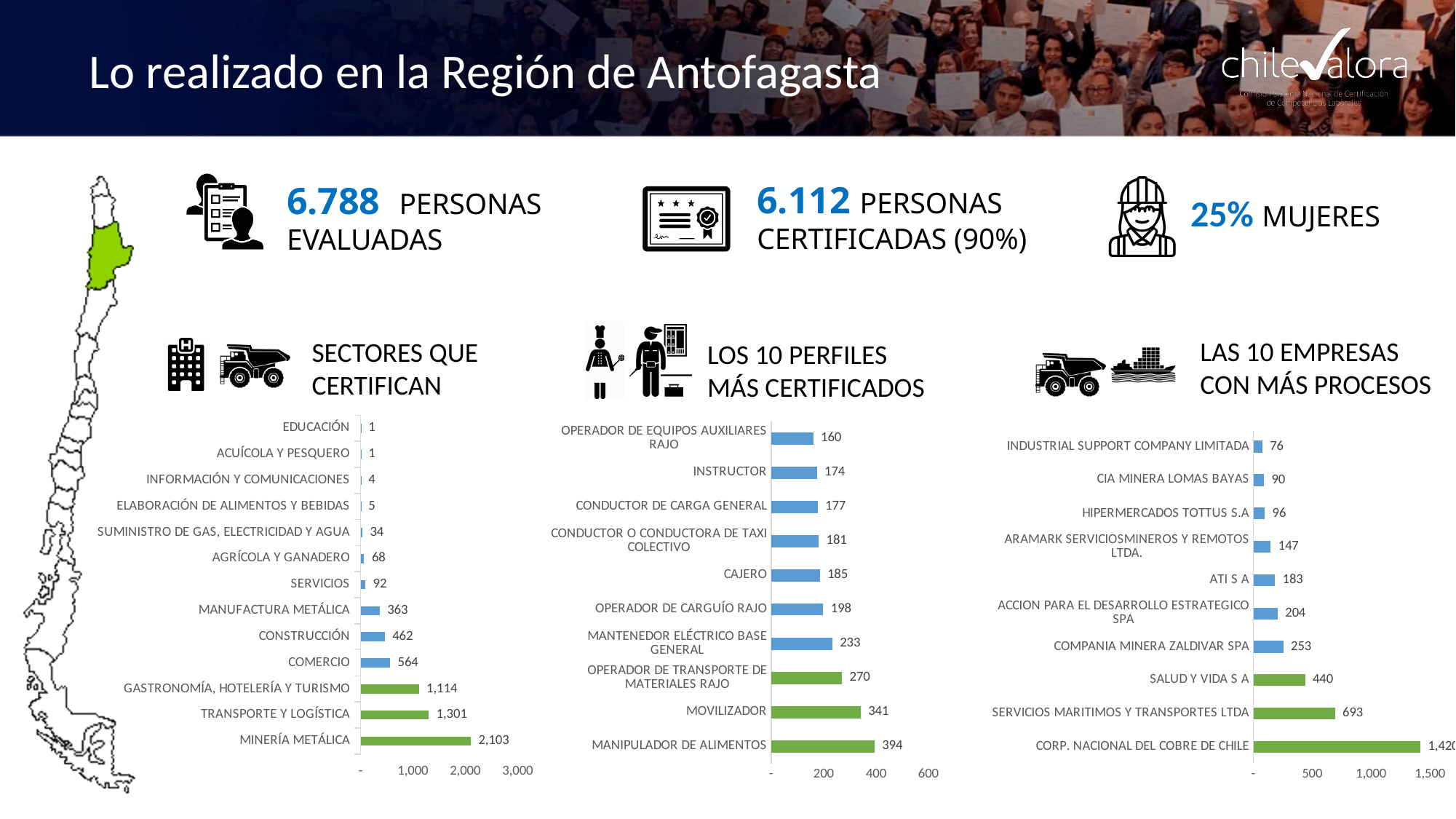
In the 'LAS 10 EMPRESAS CON MÁS PROCESOS' chart, what is the value for SERVICIOS MARITIMOS Y TRANSPORTES LTDA? 693 In the 'SECTORES QUE CERTIFICAN' chart, what is the value for CONSTRUCCIÓN? 462 In the 'SECTORES QUE CERTIFICAN' chart, what is the value for MINERÍA METÁLICA? 2,103 In the 'LAS 10 EMPRESAS CON MÁS PROCESOS' chart, which company has the highest value? CORP. NACIONAL DEL COBRE DE CHILE In the 'SECTORES QUE CERTIFICAN' chart, what is the difference between TRANSPORTE Y LOGÍSTICA and GASTRONOMÍA, HOTELERÍA Y TURISMO? 187 What type of chart is 'LAS 10 EMPRESAS CON MÁS PROCESOS'? Bar chart In the 'LAS 10 EMPRESAS CON MÁS PROCESOS' chart, what is the difference between SALUD Y VIDA S A and COMPANIA MINERA ZALDIVAR SPA? 187 In the 'LOS 10 PERFILES MÁS CERTIFICADOS' chart, what is the value for CAJERO? 185 In the 'LOS 10 PERFILES MÁS CERTIFICADOS' chart, which profile has the lowest value? OPERADOR DE EQUIPOS AUXILIARES RAJO In the 'SECTORES QUE CERTIFICAN' chart, how many sectors are listed? 13 In the 'SECTORES QUE CERTIFICAN' chart, which sector has the highest value? MINERÍA METÁLICA In the 'LOS 10 PERFILES MÁS CERTIFICADOS' chart, which is larger: MOVILIZADOR or MANTENEDOR ELÉCTRICO BASE GENERAL? MOVILIZADOR